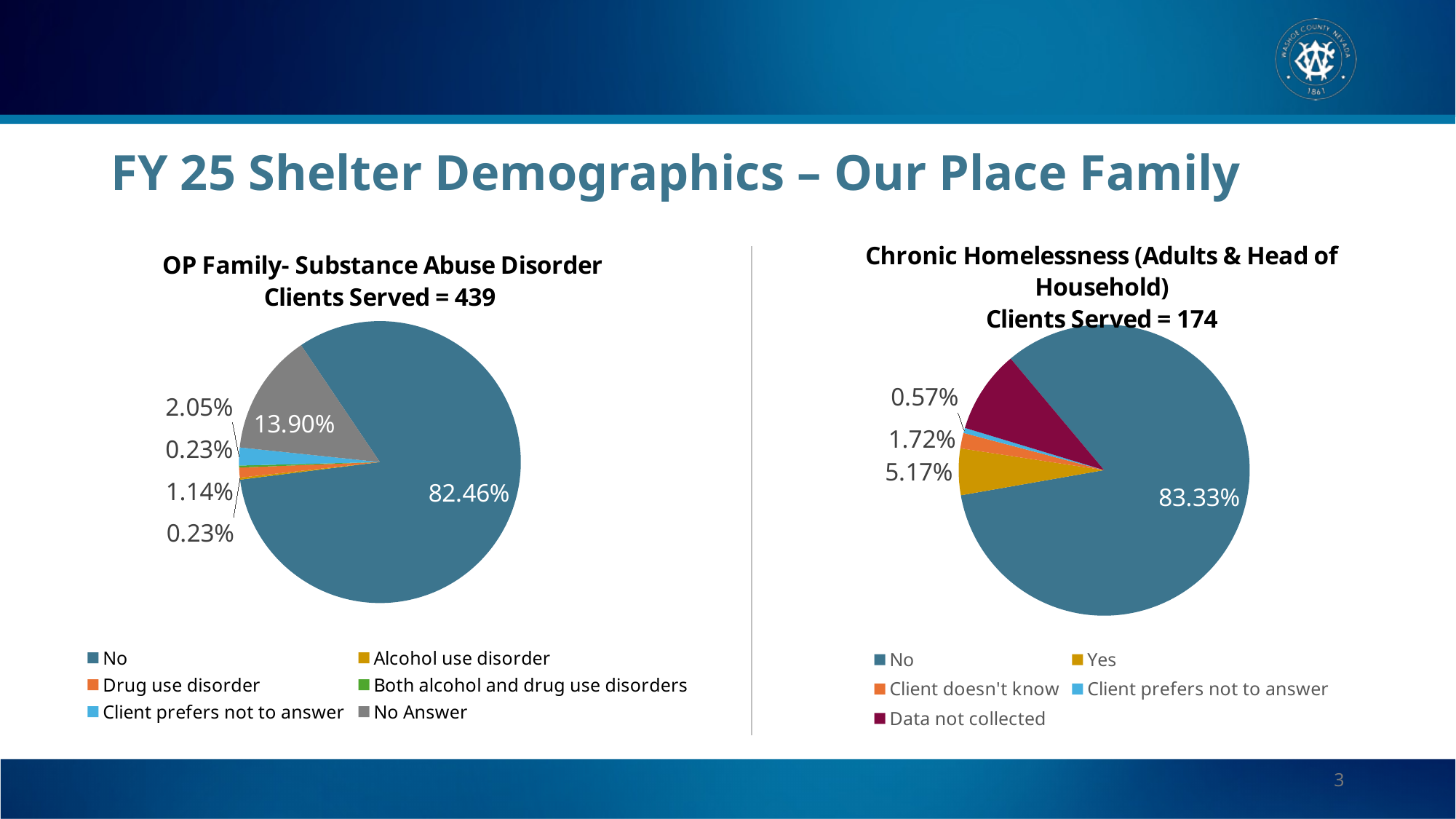
In the 'Chronic Homelessness (Adults & Head of Household)' chart, what share of clients is labelled 'No'? 83.33% In the 'OP Family- Substance Abuse Disorder' chart, what is the difference between the 'No' share and the 'No Answer' share? 68.56% How many categories does the legend of the 'OP Family- Substance Abuse Disorder' chart list? 6 In the 'Chronic Homelessness (Adults & Head of Household)' chart, what share of clients is 'Yes'? 5.17% In the 'OP Family- Substance Abuse Disorder' chart, which category has the largest slice? No In the 'OP Family- Substance Abuse Disorder' chart, what share of clients is 'No Answer'? 13.90% How many clients were served according to the title of the 'OP Family- Substance Abuse Disorder' chart? 439 How many categories does the legend of the 'Chronic Homelessness (Adults & Head of Household)' chart list? 5 What kind of chart is the 'OP Family- Substance Abuse Disorder' chart on the left? Pie chart How many clients were served according to the title of the 'Chronic Homelessness (Adults & Head of Household)' chart? 174 In the 'Chronic Homelessness (Adults & Head of Household)' chart, which is larger: the 'Data not collected' slice or the 'Yes' slice? Data not collected